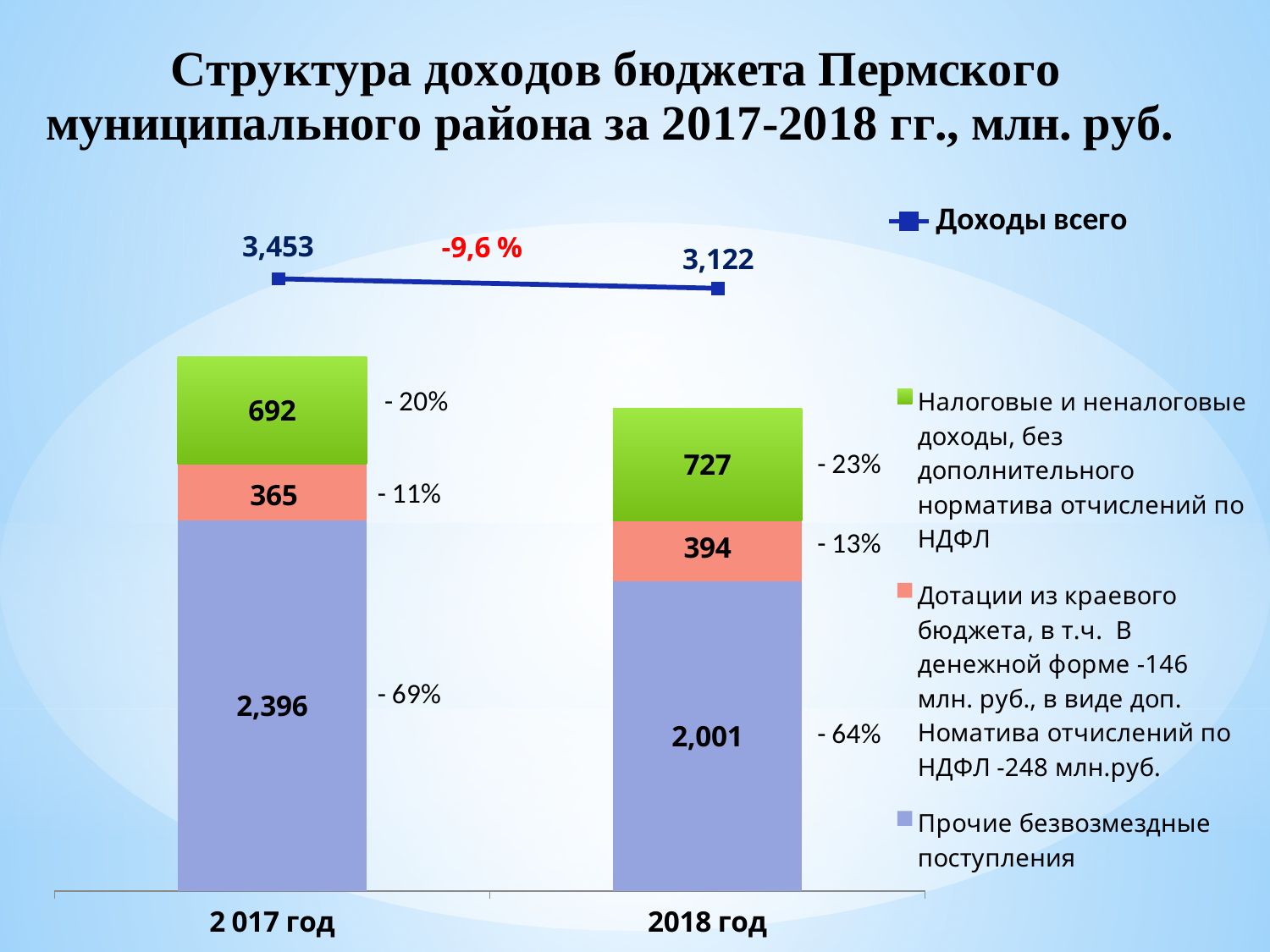
What is the difference between 'Налоговые и неналоговые доходы' in 2018 год and 2017 год? 35 What kind of chart is this? Stacked bar chart with a line Which segment is the smallest in the 2017 год bar? Дотации из краевого бюджета (365) How many year categories are shown on the x axis? 2 What share of the 2018 год bar does 'Прочие безвозмездные поступления' represent, according to the label? 64% What percentage change in total income is shown between 2017 and 2018? -9,6 % What is the value of 'Налоговые и неналоговые доходы' for 2018 год? 727 What is the total 'Доходы всего' for 2017 год? 3,453 What is the value of 'Прочие безвозмездные поступления' for 2017 год? 2,396 What is the value of 'Дотации из краевого бюджета' for 2018 год? 394 What is the total 'Доходы всего' for 2018 год? 3,122 Which year has the larger value for 'Прочие безвозмездные поступления'? 2 017 год